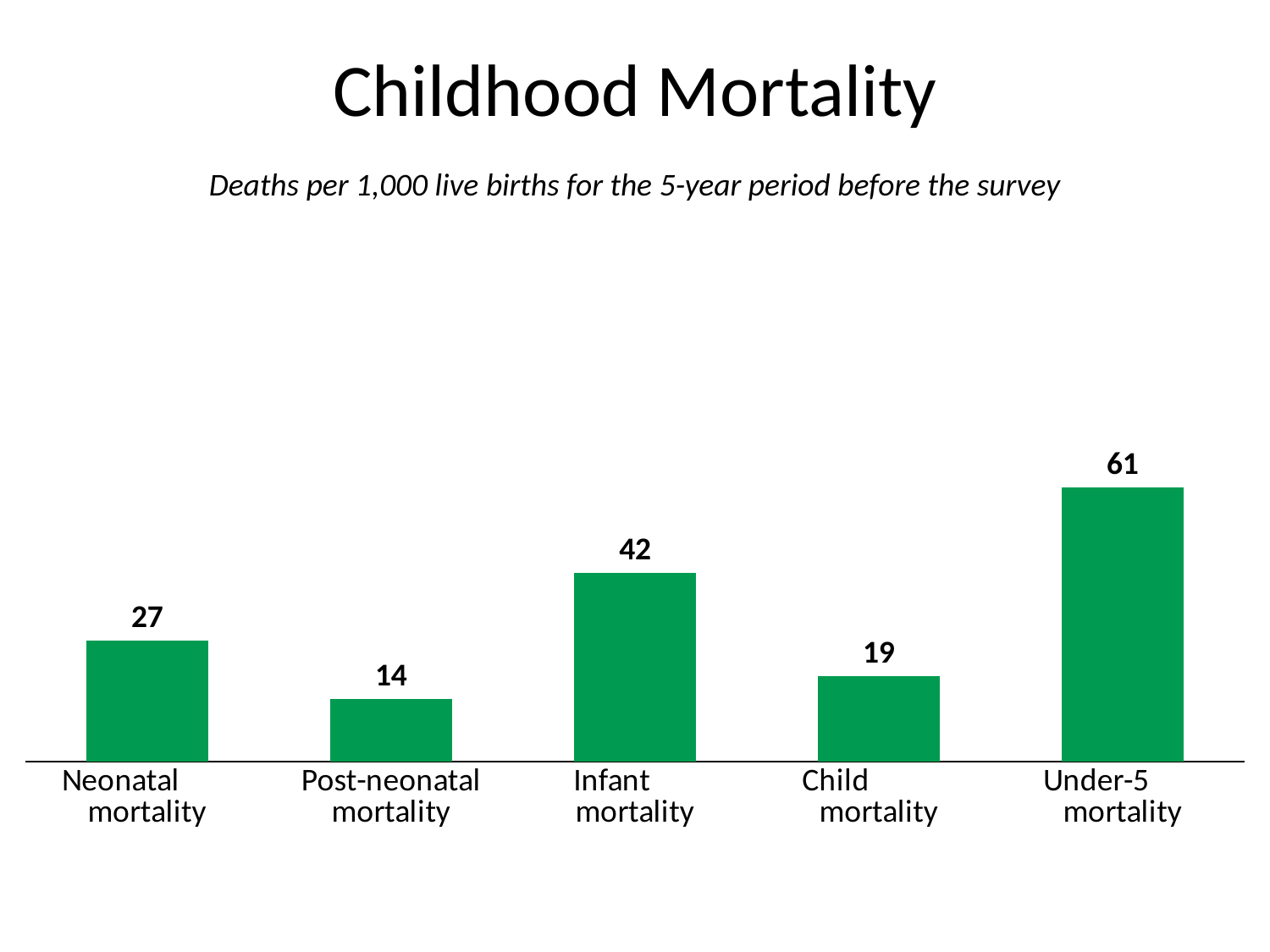
What is the value for Infant mortality? 42 Which category has the lowest value? Post-neonatal mortality What is the title of the slide? Childhood Mortality What kind of chart is shown on the slide? Bar chart What is the value for Post-neonatal mortality? 14 How many categories are shown in the chart? 5 What is the value for Child mortality? 19 What is the value for Under-5 mortality? 61 What is the difference between Under-5 mortality and Infant mortality? 19 Which category has the highest value? Under-5 mortality Which is larger, Neonatal mortality or Child mortality? Neonatal mortality What is the value for Neonatal mortality? 27